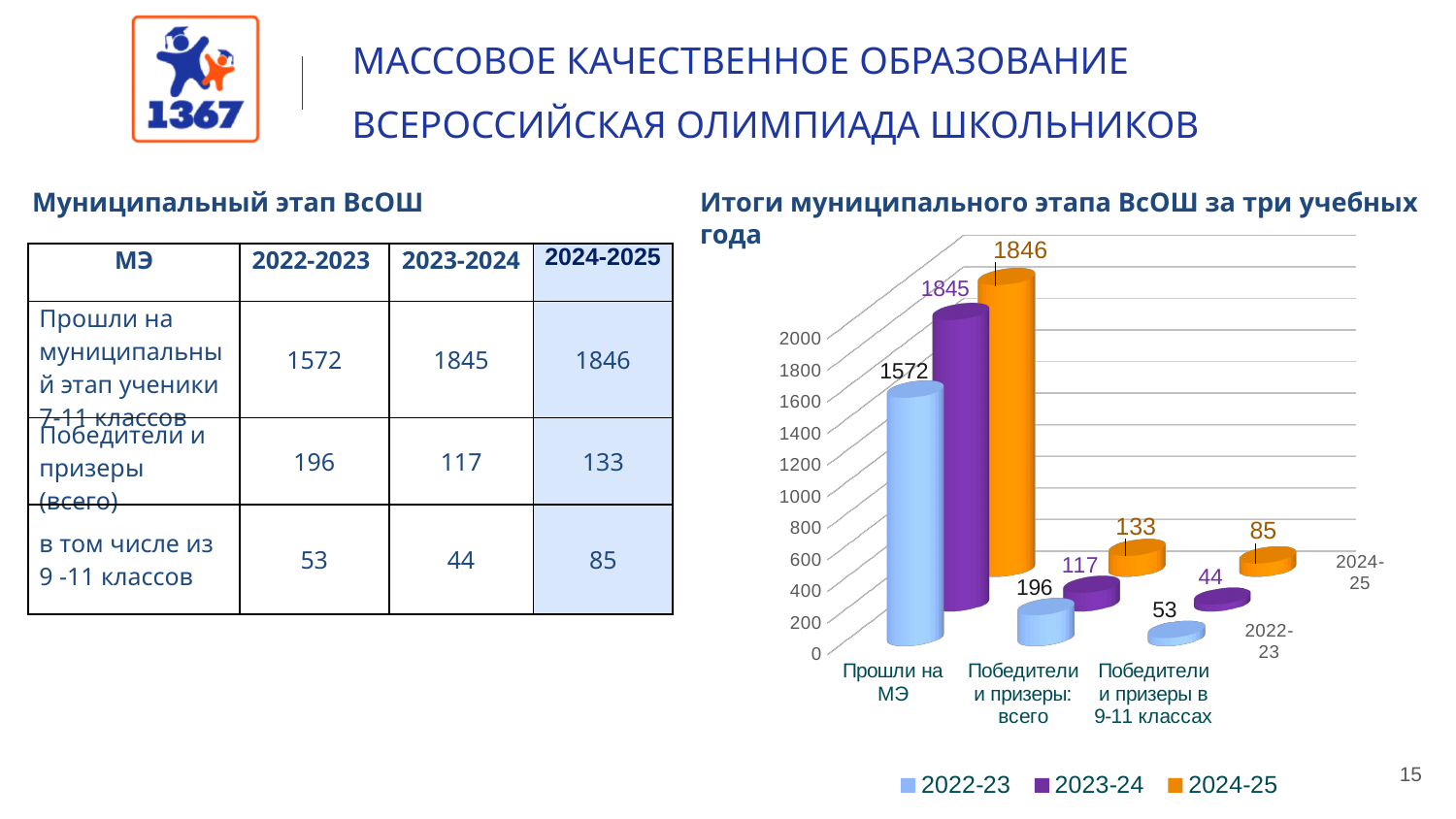
What is the value for 'Прошли на МЭ' in the 2024-25 series? 1846 Which is larger for 'Победители и призеры: всего': the 2024-25 value or the 2023-24 value? 2024-25 How many series does the chart legend list? 3 What is the value for 'Победители и призеры: всего' in the 2022-23 series? 196 What colour are the bars for the 2024-25 series in the chart? orange Is the value for 'Прошли на МЭ' in the 2022-23 series greater or less than 1400? greater What kind of chart is shown on the slide? bar chart What is the value for 'Победители и призеры в 9-11 классах' in the 2023-24 series? 44 How many categories are shown on the x axis of the chart? 3 Which series has the lowest value for 'Победители и призеры: всего'? 2023-24 What is the difference between the 2023-24 and 2022-23 values for 'Прошли на МЭ'? 273 Which series has the highest value for 'Победители и призеры в 9-11 классах'? 2024-25